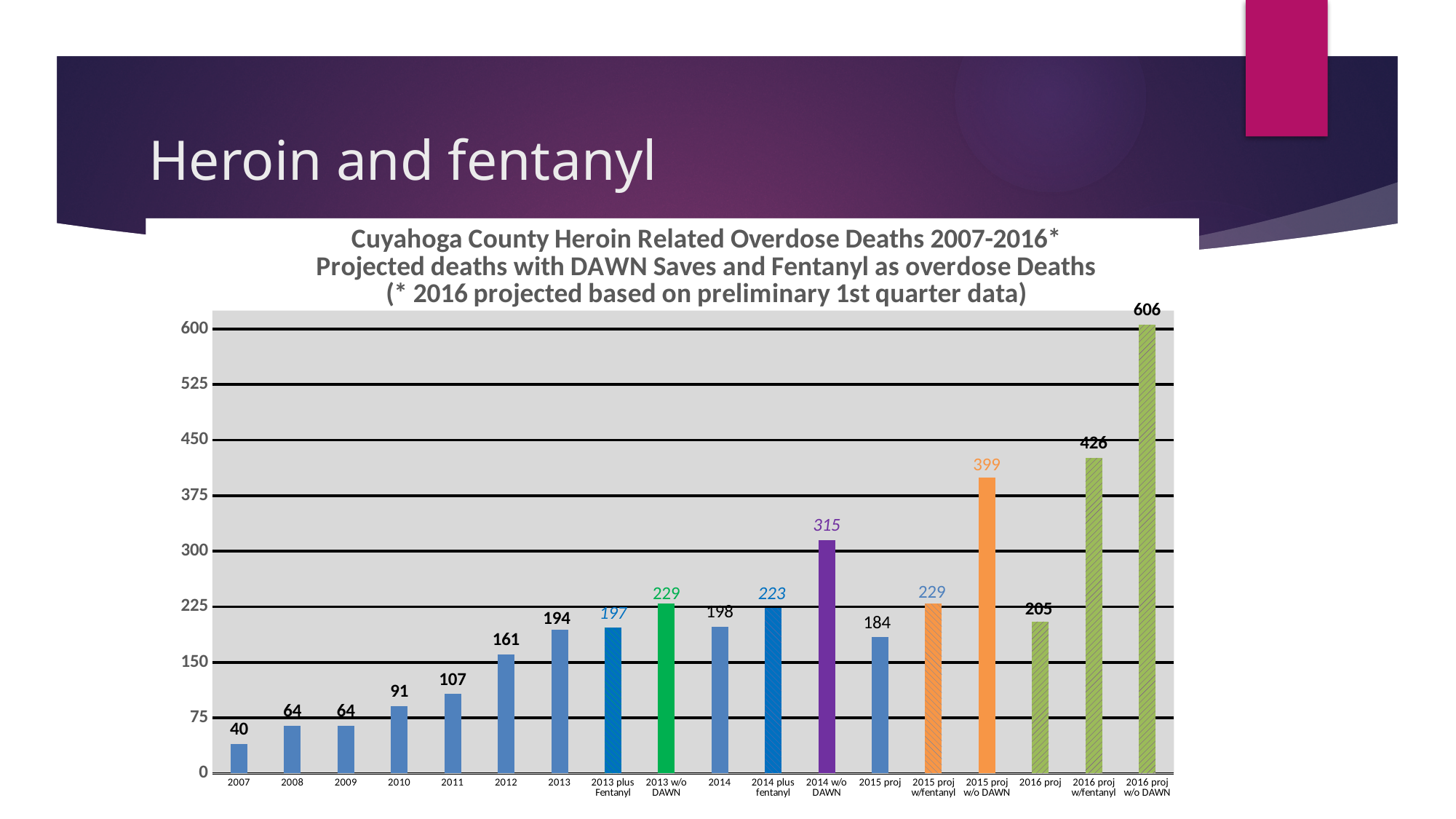
Which category has the highest value? 2016 proj w/o DAWN How many bars are shown in the chart? 18 What is the difference between the values for 2016 proj w/o DAWN and 2016 proj? 401 Do the values rise or fall from 2007 to 2012? Rise What is the value for 2015 proj w/o DAWN? 399 What is the difference between the values for 2012 and 2011? 54 What is the value for 2014 w/o DAWN? 315 Which category has the lowest value? 2007 Which is larger, the value for 2013 w/o DAWN or the value for 2014 plus fentanyl? 2013 w/o DAWN What is the value for 2007? 40 What kind of chart is shown on the slide? Bar chart What is the value for 2016 proj w/fentanyl? 426